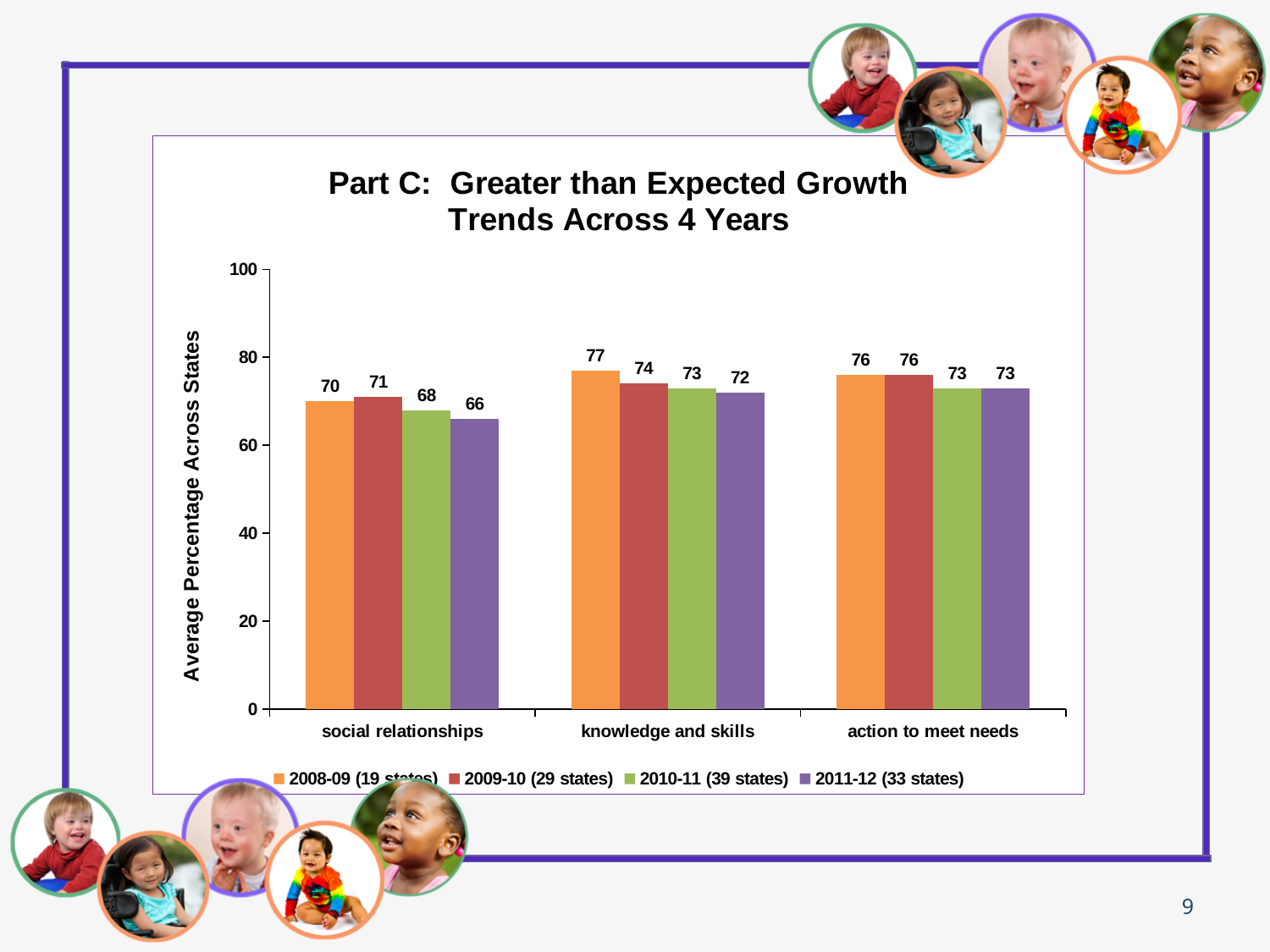
What is the value for action to meet needs in the 2010-11 (39 states) series? 73 What is the value for social relationships in the 2008-09 (19 states) series? 70 What is the value for knowledge and skills in the 2011-12 (33 states) series? 72 How many series does the legend list? 4 Which is larger: the 2009-10 (29 states) value for social relationships or the 2009-10 (29 states) value for knowledge and skills? knowledge and skills What is the difference between the 2008-09 (19 states) and 2011-12 (33 states) values for knowledge and skills? 5 What is the label of the y axis? Average Percentage Across States What is the difference between the 2008-09 (19 states) and 2011-12 (33 states) values for social relationships? 4 Which category has the highest value in the 2008-09 (19 states) series? knowledge and skills What kind of chart is shown on the slide? bar chart Which category has the lowest value in the 2011-12 (33 states) series? social relationships How many categories are shown on the x axis? 3